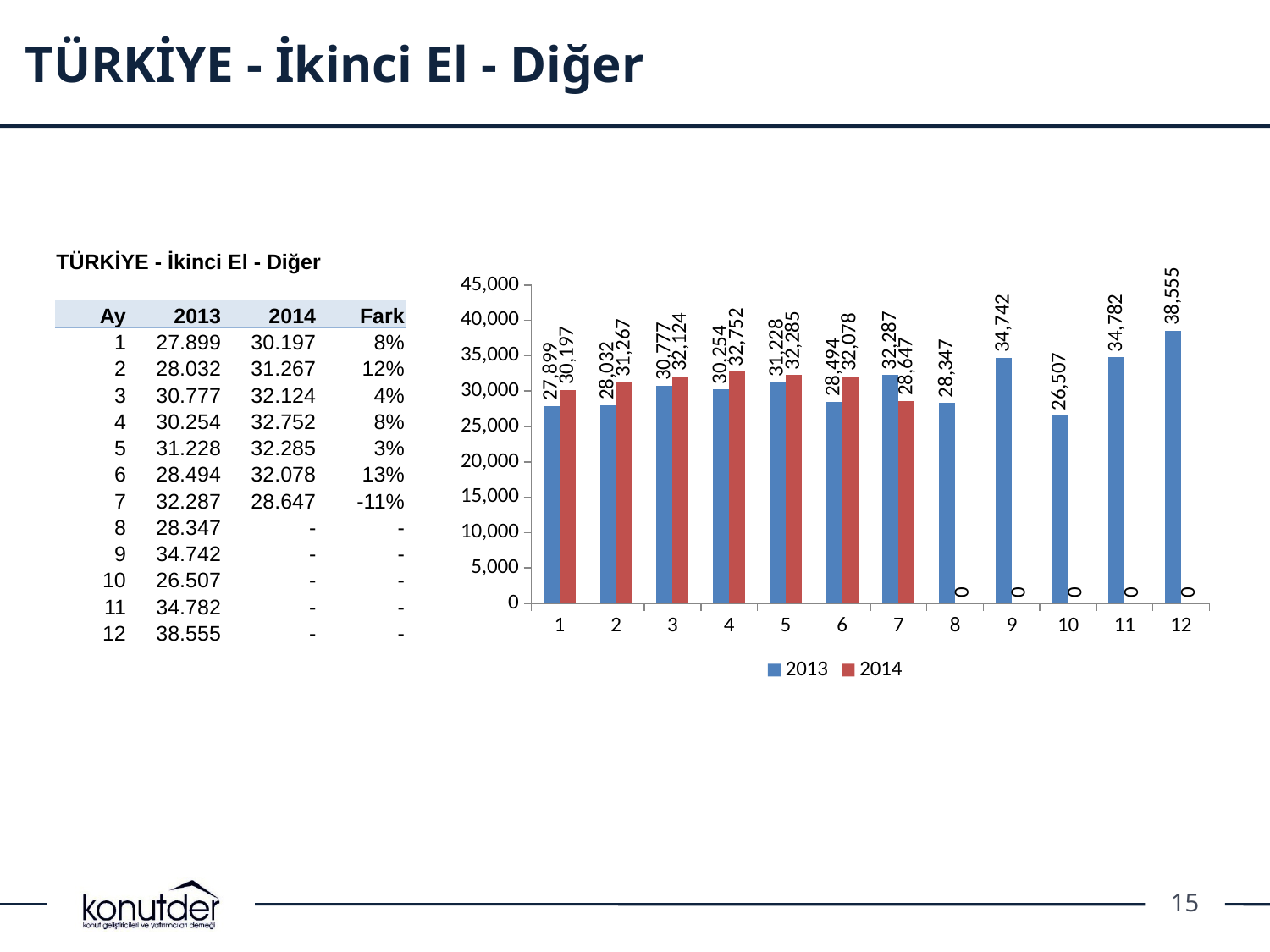
Which colour represents the 2014 series in the chart? red Which month has the lowest 2013 value in the chart? 10 How many series does the chart legend list? 2 What is the 2013 value for month 12 in the chart? 38,555 What is the difference between the 2014 and 2013 values for month 1? 2,298 What type of chart is shown on the slide? bar chart What is the 2014 value for month 4 in the chart? 32,752 Which month has the highest 2013 value in the chart? 12 What is the 2013 value for month 10 in the chart? 26,507 Which month has the highest 2014 value among the months with 2014 data? 4 For month 7, which is larger: the 2013 value or the 2014 value? 2013 How many months are shown on the x axis of the chart? 12